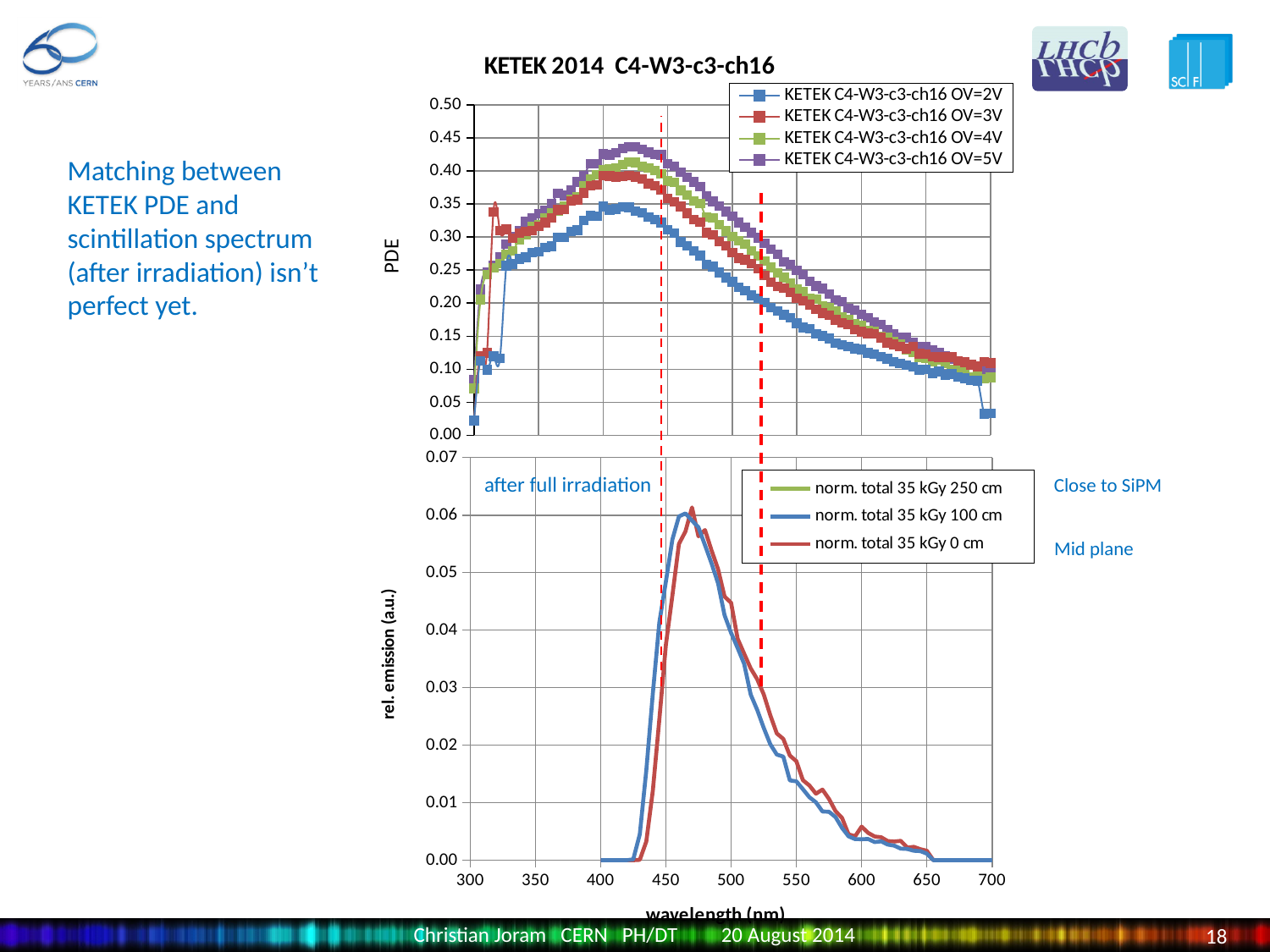
In the top chart, which series has the lowest PDE across the wavelength range? KETEK C4-W3-c3-ch16 OV=2V In the top chart, at 600 nm, which series has the larger PDE: OV=5V or OV=2V? OV=5V What kind of chart is the top chart (PDE vs wavelength)? line chart What is the y-axis label of the bottom chart? rel. emission (a.u.) In the bottom chart, is the peak of the 'norm. total 35 kGy 0 cm' series greater or less than 0.05? greater How many series does the legend of the bottom chart list? 3 In the top chart, do the PDE values rise or fall as wavelength increases from 450 nm to 700 nm? fall In the top chart, is the peak PDE of the OV=5V series greater or less than 0.40? greater How many series does the legend of the top chart list? 4 What is the title of the top chart? KETEK 2014 C4-W3-c3-ch16 In the top chart, which series reaches the highest peak PDE? KETEK C4-W3-c3-ch16 OV=5V In the top chart, is the peak PDE of the OV=2V series greater or less than 0.40? less